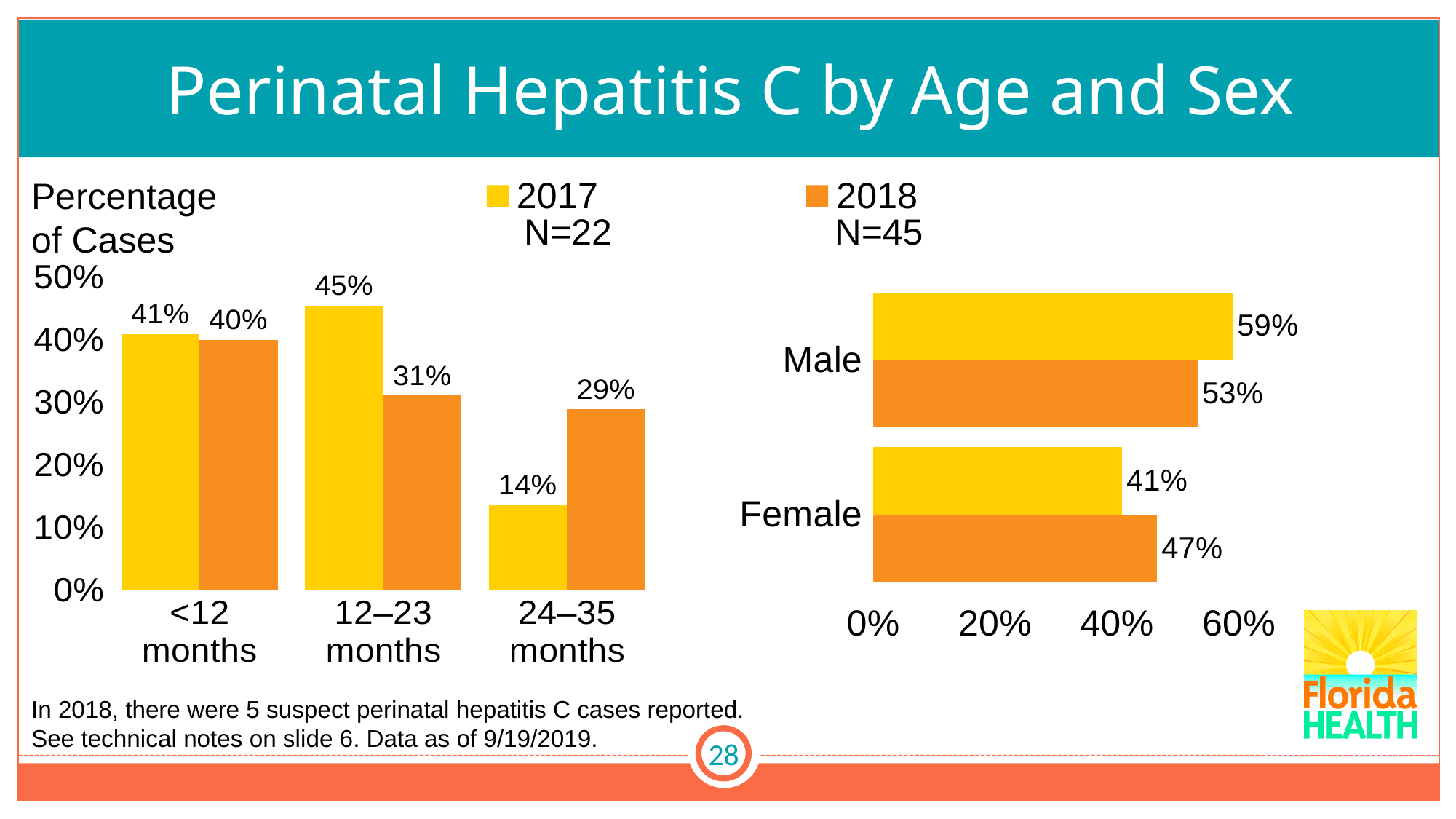
How many series does the legend list? 2 In the left chart (by age), which age group has the highest 2017 value? 12–23 months What kind of chart is the right chart (by sex)? Bar chart In the right chart (by sex), what is the 2017 value for Female? 41% In the left chart (by age), what is the 2017 value for <12 months? 41% In the left chart (by age), what is the 2018 value for 24–35 months? 29% In the left chart (by age), what is the difference between the 2017 and 2018 values for 12–23 months? 14% In the left chart (by age), how many age groups are shown? 3 In the right chart (by sex), what is the 2018 value for Male? 53% In the left chart (by age), is the 2017 or 2018 value larger for 24–35 months? 2018 In the right chart (by sex), what is the difference between the 2017 Male and 2017 Female values? 18% In the left chart (by age), which age group has the lowest 2017 value? 24–35 months